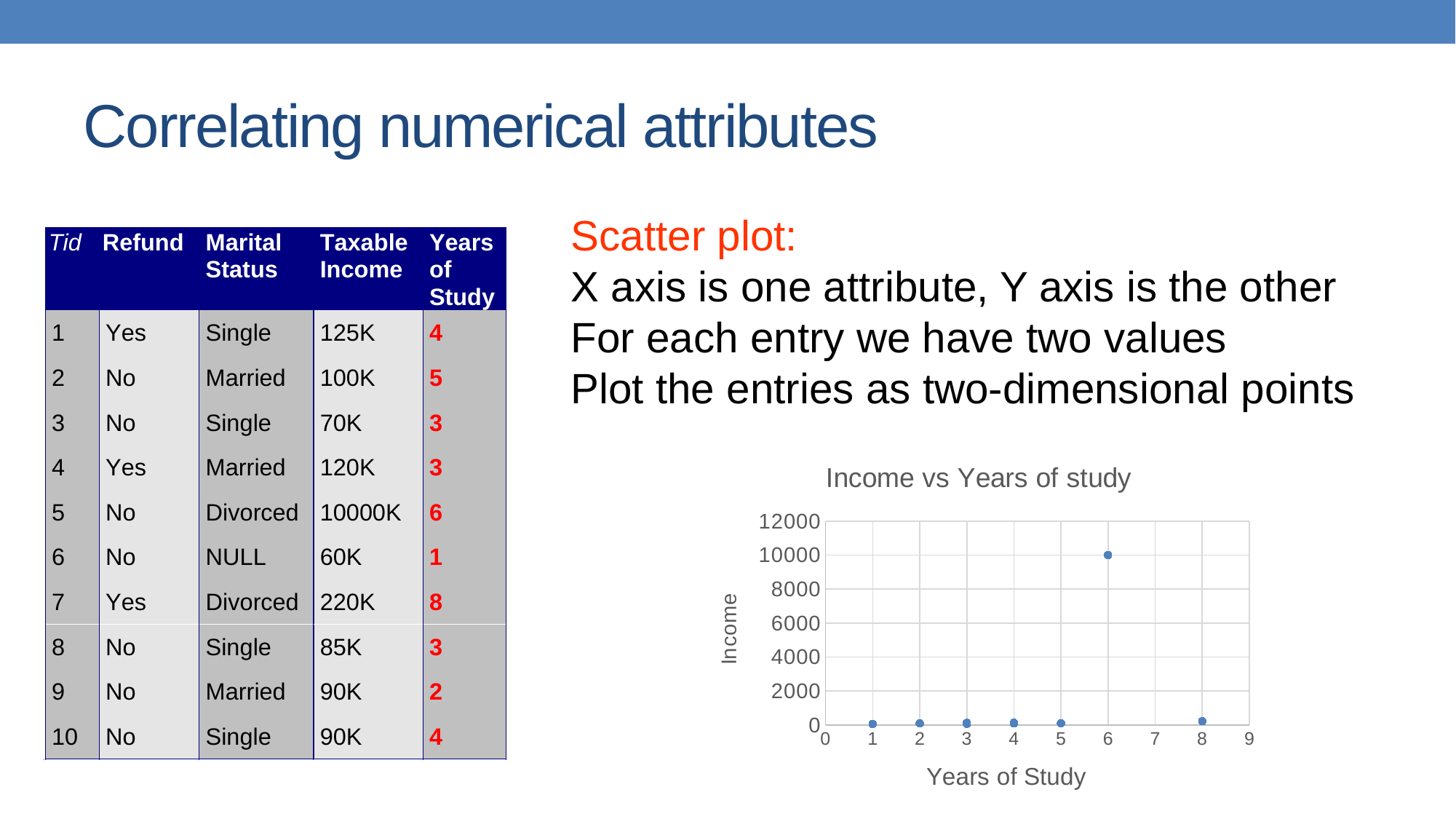
What is the label of the x axis of the chart? Years of Study Is the Income for the point at 1 Year of Study greater or less than 2000? less What is the highest tick value shown on the Income axis? 12000 Is the Income for the point at 8 Years of Study greater or less than 2000? less Is the Income for the point at 6 Years of Study greater or less than 8000? greater Which point has a larger Income: the one at 6 Years of Study or the one at 8 Years of Study? 6 Years of Study What kind of chart is shown on the slide? scatter plot At which value of Years of Study is the Income highest in the chart? 6 How many distinct points are visible in the scatter plot? 7 What Income value does the point at 6 Years of Study land on? 10000 What is the title of the chart? Income vs Years of study